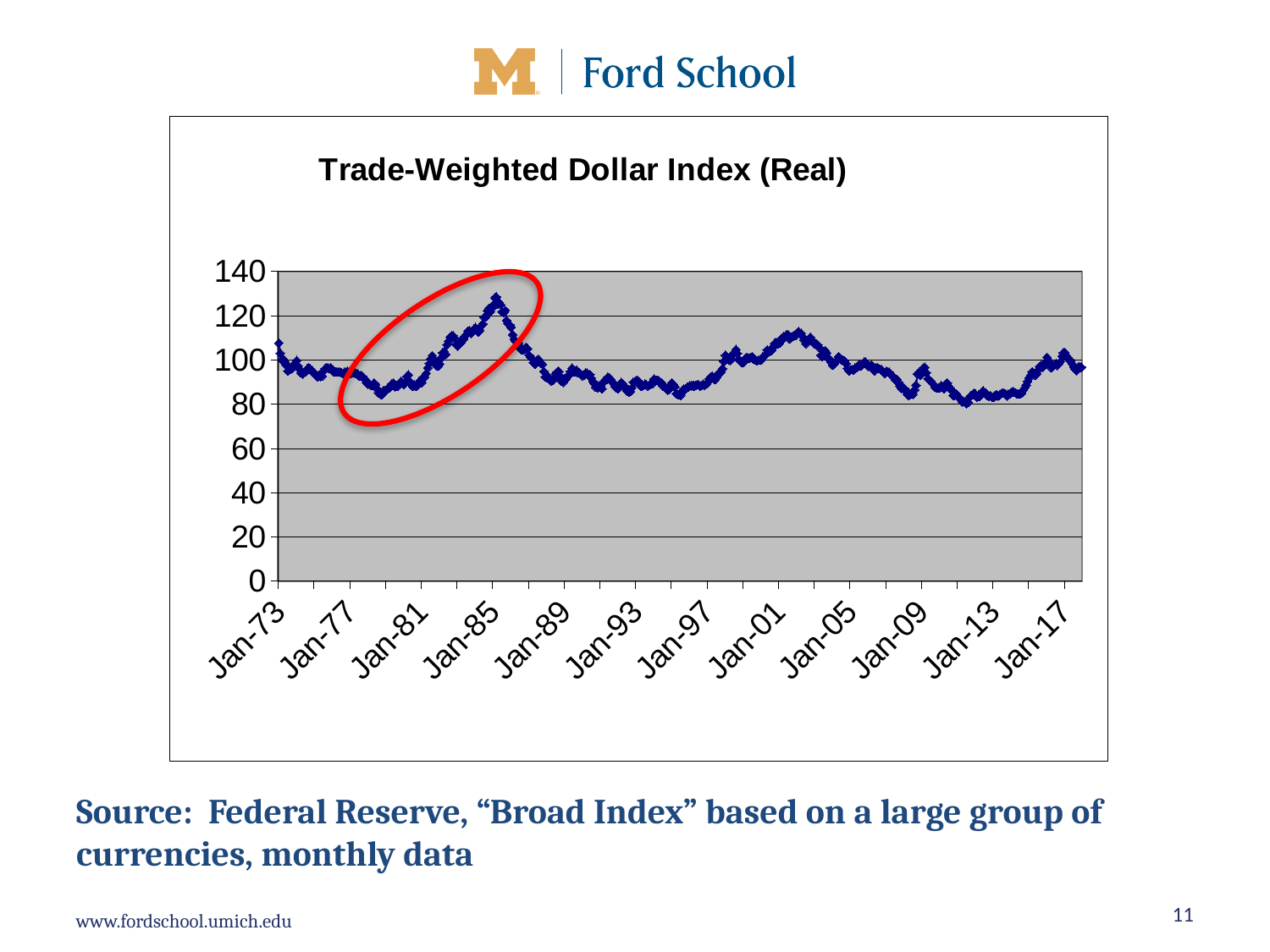
What is the title of the chart? Trade-Weighted Dollar Index (Real) Is the value of the index around Jan-77 greater or less than 100? less Does the index rise or fall between Jan-81 and Jan-85? rise Is the value of the index at Jan-73 greater or less than 80? greater Is the peak value of the index around Jan-01 greater or less than 100? greater What is the highest value shown on the y axis? 140 Around which x-axis label does the index reach its highest value? Jan-85 Does the index rise or fall between Jan-85 and Jan-89? fall What kind of chart is shown on the slide? line chart Which is higher: the peak of the index around Jan-85 or the peak around Jan-01? the peak around Jan-85